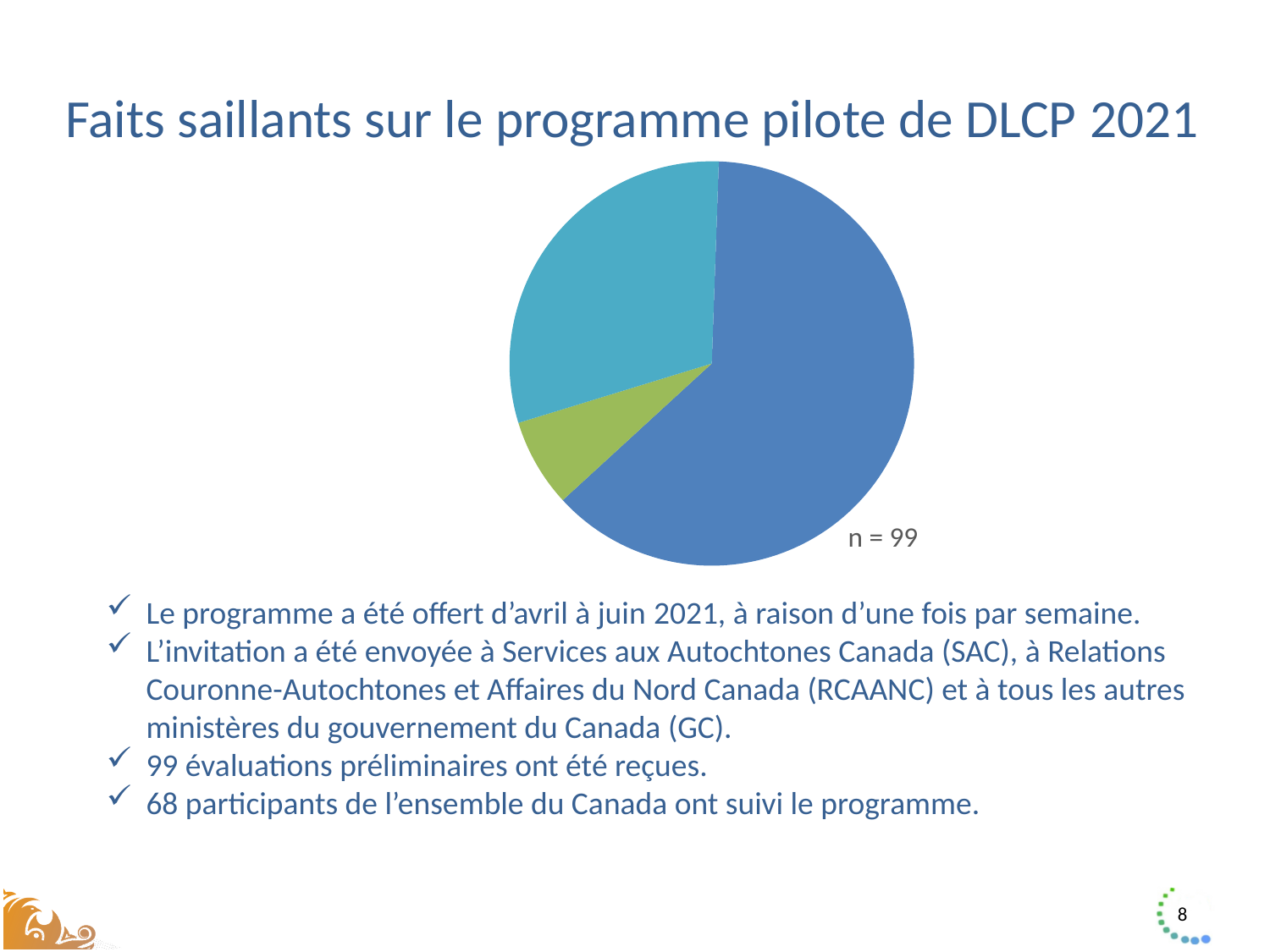
Which is larger in the pie chart, the teal slice or the green slice? teal Which colour slice of the pie chart is the largest? blue How many slices does the pie chart have? 3 What kind of chart is shown on the slide? pie chart What sample size annotation is printed next to the pie chart? n = 99 Which is larger in the pie chart, the blue slice or the green slice? blue